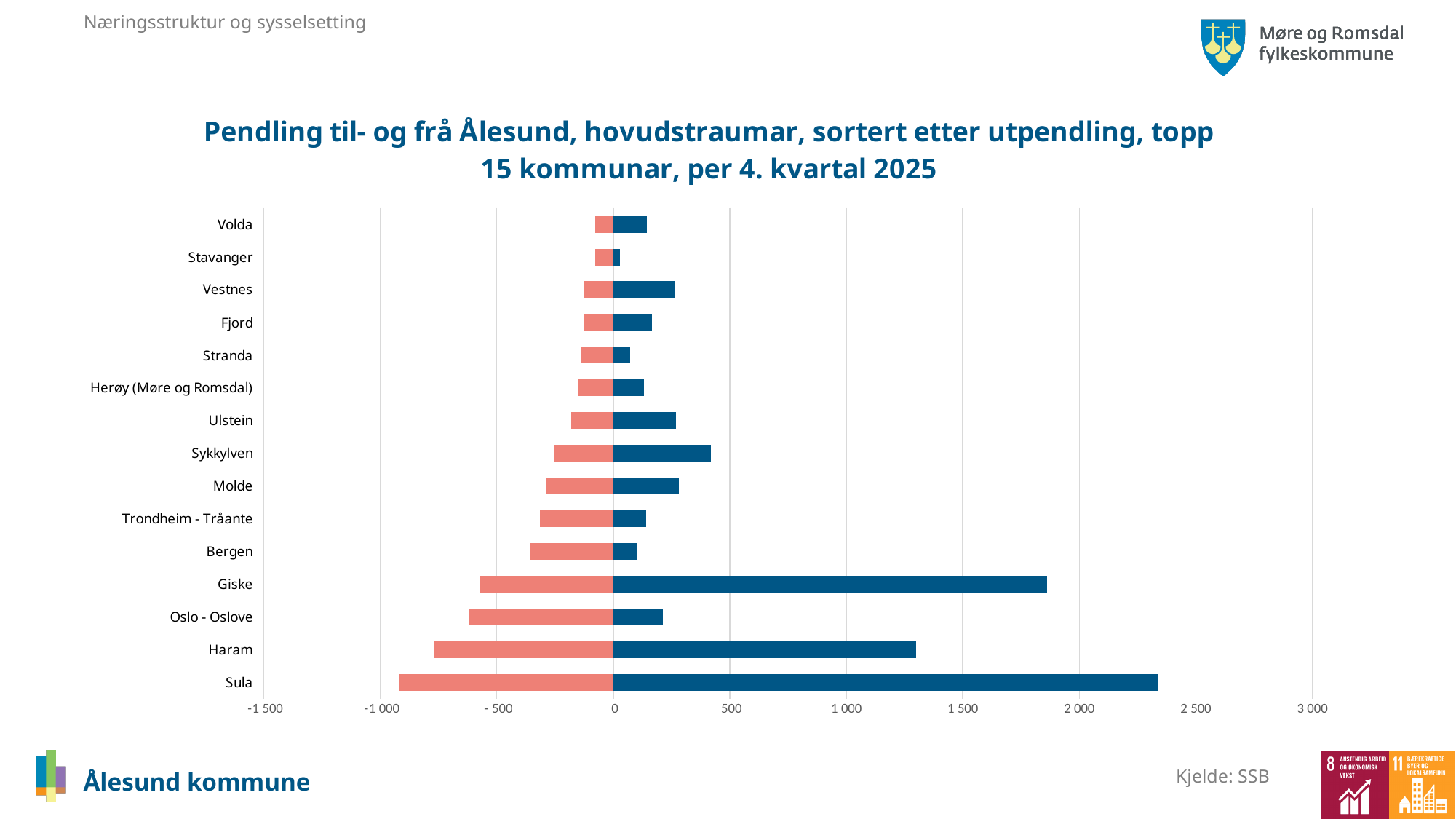
Which municipality is listed at the bottom of the chart? Sula Which has the longer blue bar, Sykkylven or Molde? Sykkylven What kind of chart is shown on the slide? bar chart Is the blue bar value for Haram greater or less than 1 000? greater Which municipality has the longest red (negative) bar? Sula Is the blue bar value for Giske greater or less than 1 500? greater Is the blue bar value for Sula greater or less than 2 000? greater Which municipality has the longest blue (positive) bar? Sula Which municipality has the shortest blue (positive) bar? Stavanger Which has the longer blue bar, Giske or Haram? Giske How many municipalities (categories) are listed on the chart? 15